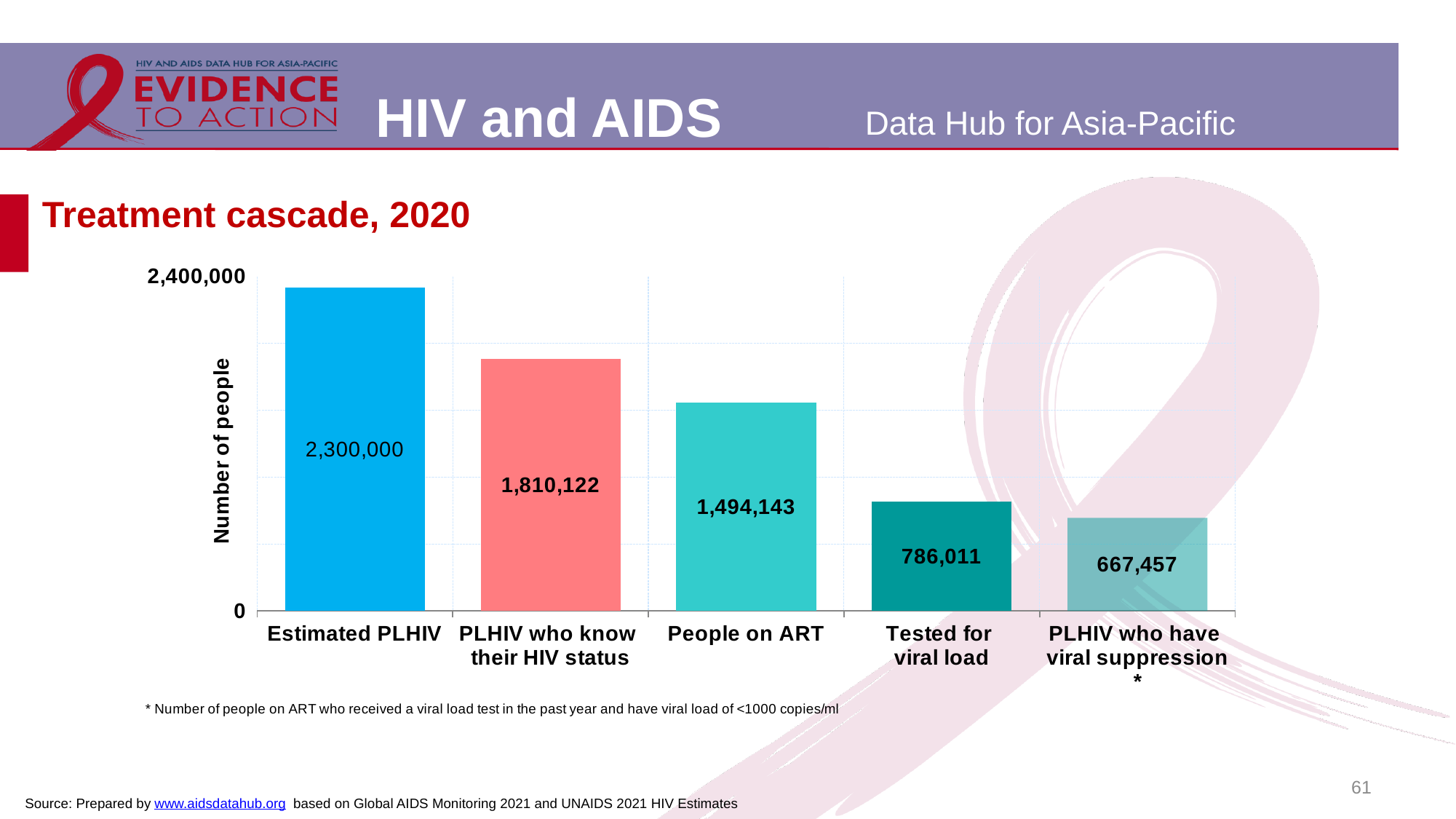
What is the value for PLHIV who have viral suppression? 667,457 What kind of chart is shown on the slide? Bar chart Which category has the lowest value? PLHIV who have viral suppression What is the value for Estimated PLHIV? 2,300,000 What is the value for PLHIV who know their HIV status? 1,810,122 What is the value for Tested for viral load? 786,011 Which is larger, People on ART or Tested for viral load? People on ART What is the difference between Estimated PLHIV and PLHIV who know their HIV status? 489,878 Which category has the highest value? Estimated PLHIV What is the difference between Tested for viral load and PLHIV who have viral suppression? 118,554 What is the value for People on ART? 1,494,143 How many categories are shown on the chart? 5